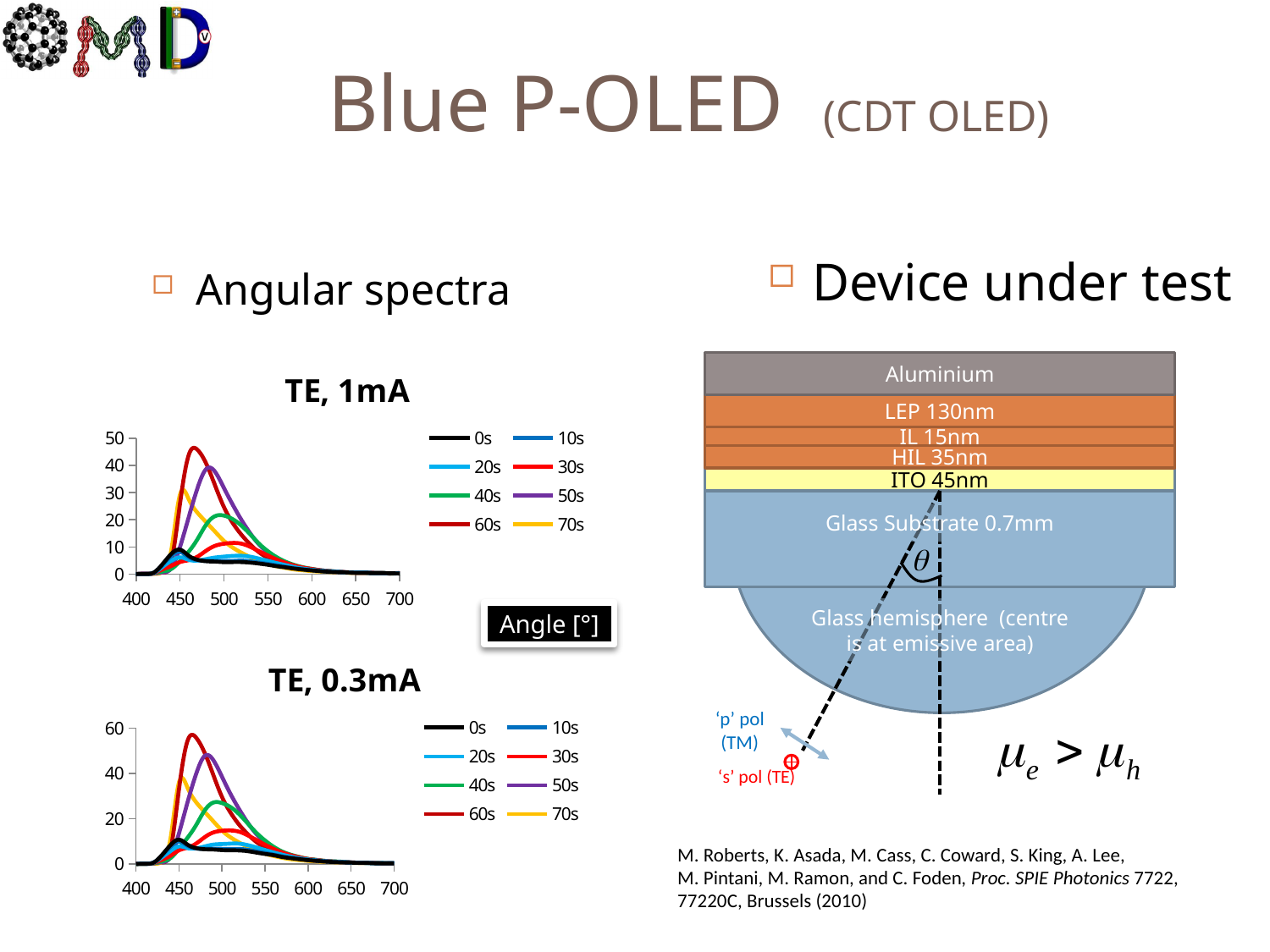
What kind of chart is the "TE, 1mA" chart? line chart How many series does the legend of the "TE, 1mA" chart list? 8 In the "TE, 1mA" chart, which series reaches the highest peak value? 60s How many series does the legend of the "TE, 0.3mA" chart list? 8 In the "TE, 0.3mA" chart, which series reaches the highest peak value? 60s In the "TE, 0.3mA" chart, is the peak value of the 40s series greater or less than 20? greater In the "TE, 1mA" chart, is the peak value of the 0s series greater or less than 20? less In the "TE, 0.3mA" chart, which series has the higher peak, 30s or 40s? 40s In the "TE, 0.3mA" chart, is the peak value of the 60s series greater or less than 40? greater In the "TE, 1mA" chart, which series has the higher peak, 60s or 50s? 60s What is the highest value shown on the y axis of the "TE, 0.3mA" chart? 60